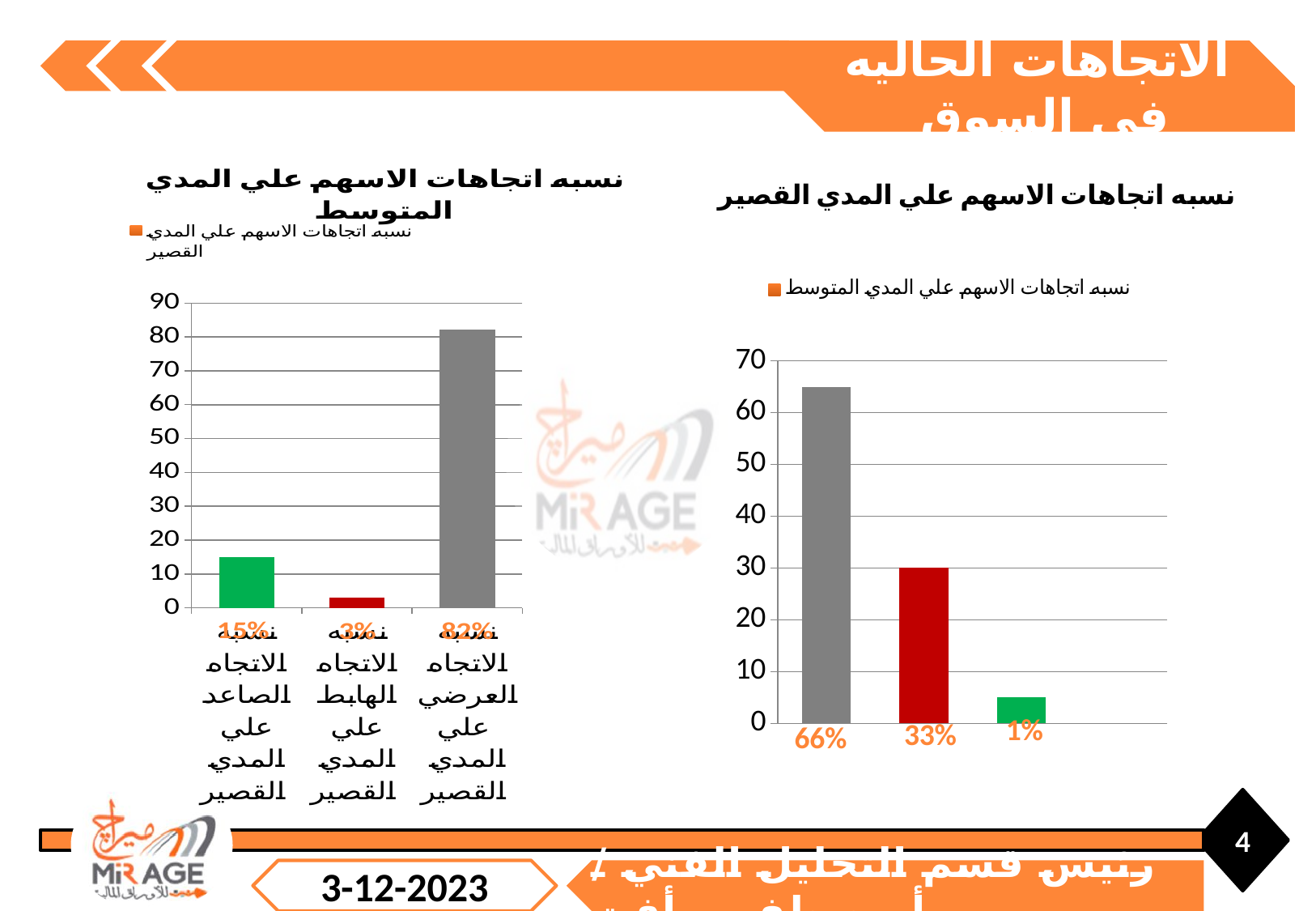
In the right chart titled 'نسبه اتجاهات الاسهم علي المدي القصير', is the middle (red) bar taller or shorter than the leftmost (gray) bar? shorter In the left chart titled 'نسبه اتجاهات الاسهم علي المدي المتوسط', which category has the highest value? نسبه الاتجاه العرضي علي المدي القصير What type of chart is the right chart titled 'نسبه اتجاهات الاسهم علي المدي القصير'? bar chart In the left chart titled 'نسبه اتجاهات الاسهم علي المدي المتوسط', what is the value shown for 'نسبه الاتجاه الهابط علي المدي القصير'? 3% In the left chart titled 'نسبه اتجاهات الاسهم علي المدي المتوسط', how many categories are plotted? 3 In the left chart titled 'نسبه اتجاهات الاسهم علي المدي المتوسط', which category has the lowest value? نسبه الاتجاه الهابط علي المدي القصير In the right chart titled 'نسبه اتجاهات الاسهم علي المدي القصير', what value label is printed under the middle (red) bar? 33% In the right chart titled 'نسبه اتجاهات الاسهم علي المدي القصير', what value label is printed under the leftmost (gray) bar? 66% In the left chart titled 'نسبه اتجاهات الاسهم علي المدي المتوسط', what is the value shown for 'نسبه الاتجاه العرضي علي المدي القصير'? 82% In the right chart titled 'نسبه اتجاهات الاسهم علي المدي القصير', is the value of the leftmost (gray) bar greater or less than 60? greater In the left chart titled 'نسبه اتجاهات الاسهم علي المدي المتوسط', what is the value shown for 'نسبه الاتجاه الصاعد علي المدي القصير'? 15% In the left chart titled 'نسبه اتجاهات الاسهم علي المدي المتوسط', what is the difference between the values for 'نسبه الاتجاه العرضي علي المدي القصير' and 'نسبه الاتجاه الصاعد علي المدي القصير'? 67%